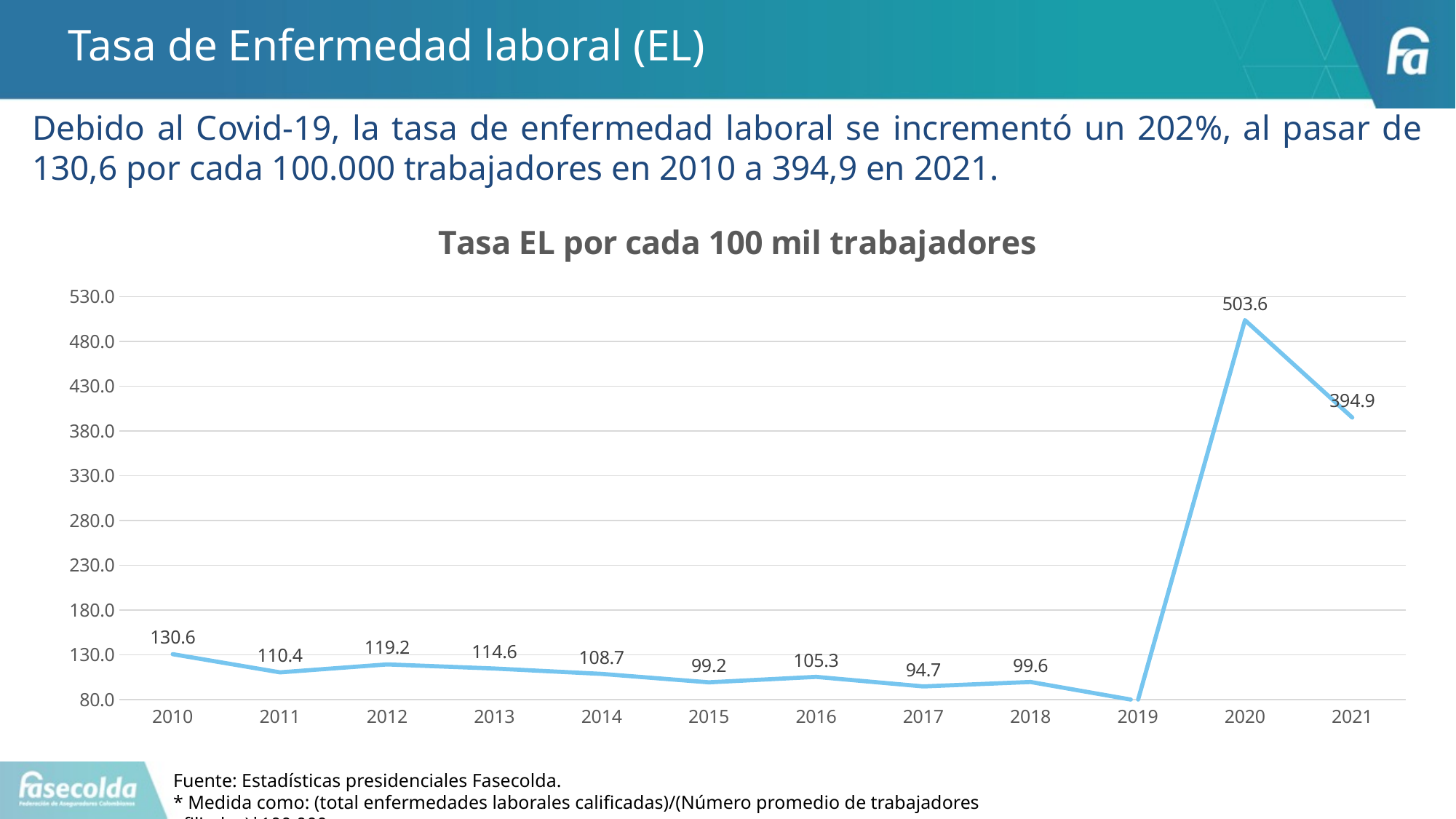
Which year has the lowest value? 2019 What is the value for 2020? 503.6 What is the value for 2021? 394.9 Which year has the highest value? 2020 Which is larger, the value for 2012 or the value for 2013? 2012 What is the value for 2017? 94.7 Is the value for 2019 greater or less than 130? less What is the value for 2010? 130.6 What kind of chart is shown? line chart What is the difference between the values for 2020 and 2021? 108.7 How many years are plotted on the chart? 12 What is the title of the chart? Tasa EL por cada 100 mil trabajadores